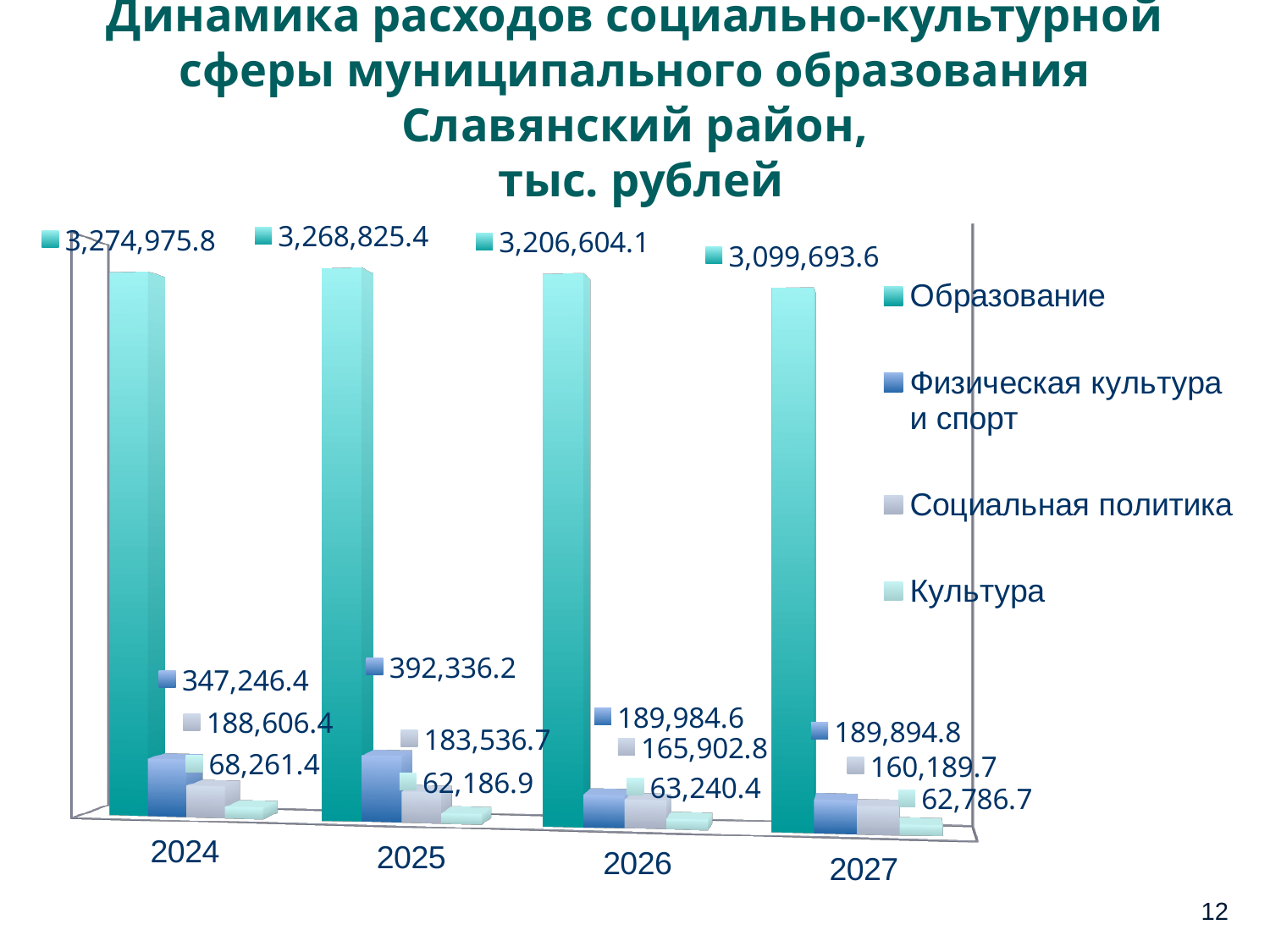
In which year is the value for Физическая культура и спорт the highest? 2025 What is the value for Физическая культура и спорт in 2025? 392,336.2 How many years are shown on the x axis? 4 What is the value for Социальная политика in 2026? 165,902.8 What is the value for Образование in 2024? 3,274,975.8 What is the value for Культура in 2027? 62,786.7 Do the values for Образование rise or fall from 2024 to 2027? Fall How many series does the legend list? 4 Which is larger: Социальная политика in 2024 or Социальная политика in 2025? 2024 What is the difference between the Образование values for 2024 and 2027? 175,282.2 In which year is the value for Образование the lowest? 2027 What kind of chart is shown on the slide? Bar chart